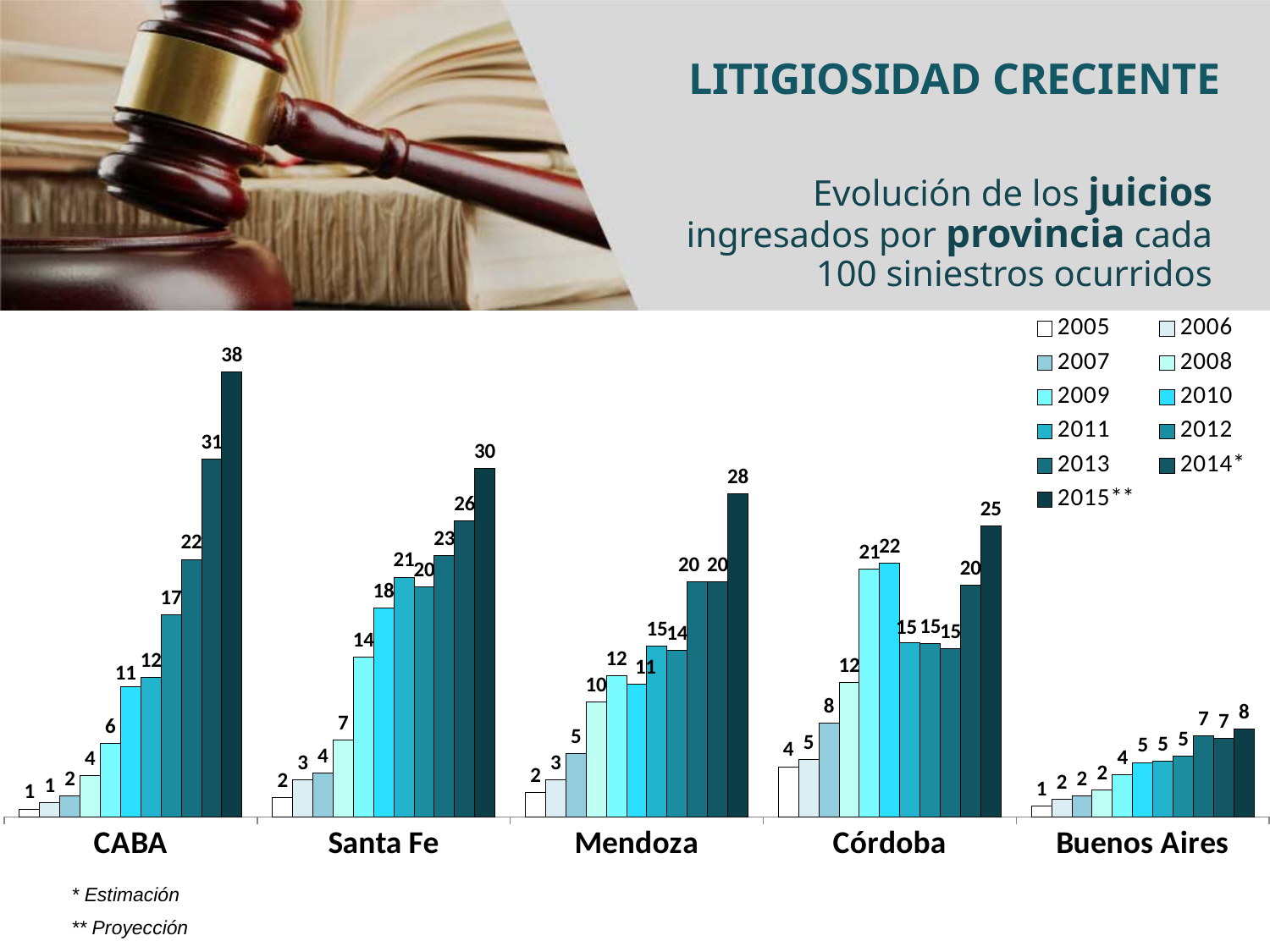
How many series does the legend list? 11 What is the difference between the 2015** values for CABA and Santa Fe? 8 What is the value for Mendoza in 2013? 20 What is the value for CABA in 2015**? 38 Which province has the highest value in 2015**? CABA Which is larger, the 2014* value for Córdoba or the 2014* value for Mendoza? Mendoza and Córdoba are equal (20) Which province has the lowest value in 2015**? Buenos Aires Do the values for CABA rise or fall from 2005 to 2015**? Rise What is the value for Santa Fe in 2009? 14 What is the value for Córdoba in 2010? 22 How many provinces are shown on the x axis? 5 What kind of chart is shown on the slide? Bar chart